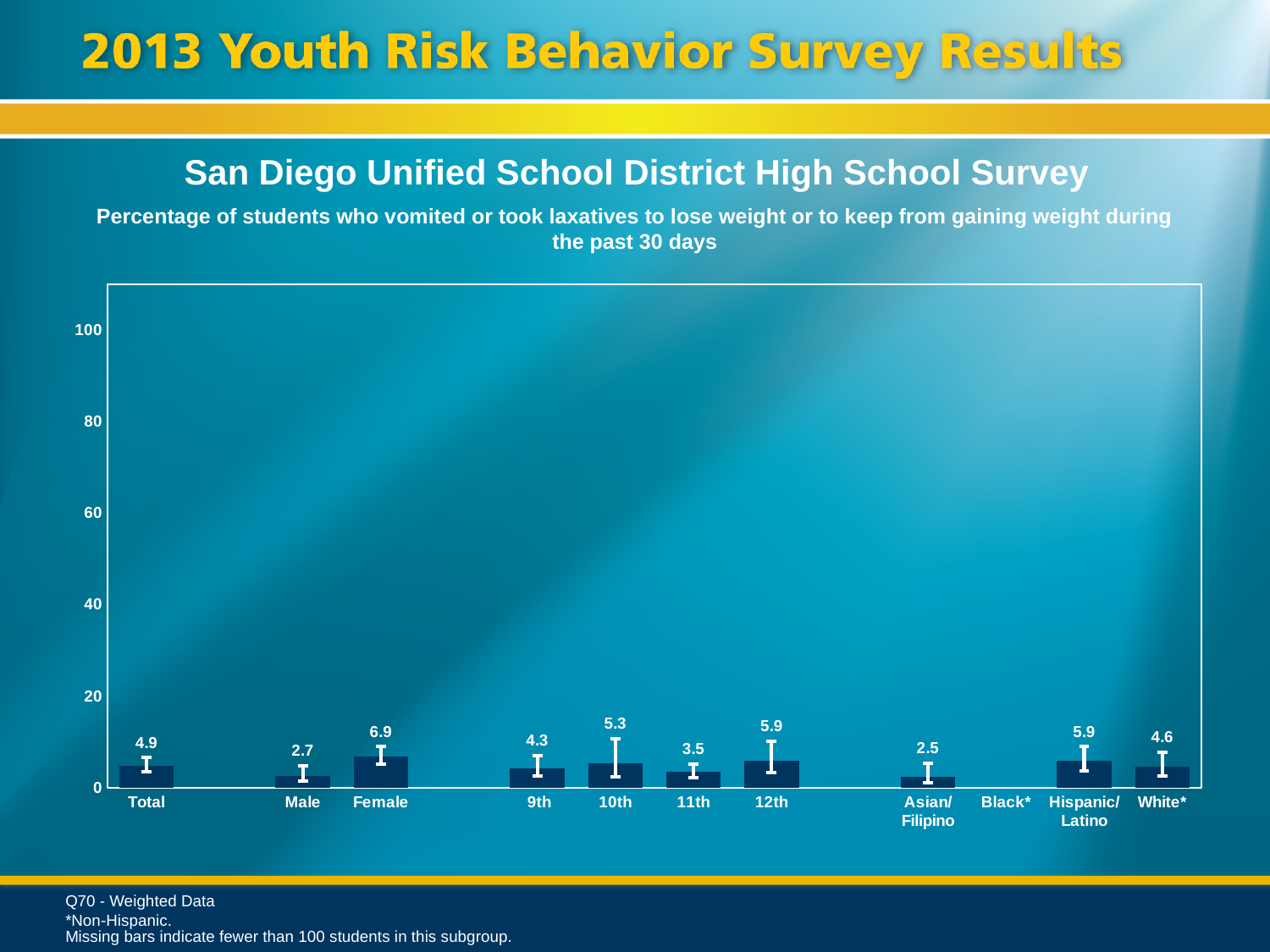
Which category with a plotted bar has the lowest value? Asian/Filipino What is the value for 12th grade? 5.9 Which category has the highest value? Female What is the value for Asian/Filipino? 2.5 Is the value for Total greater or less than 20? less What is the value for Female? 6.9 What is the difference between the 12th and 11th grade values? 2.4 What kind of chart is shown? bar chart What is the difference between the Female and Male values? 4.2 Which category label on the x axis has no bar plotted? Black* Which is larger, the value for 10th grade or 9th grade? 10th What is the value for Total? 4.9